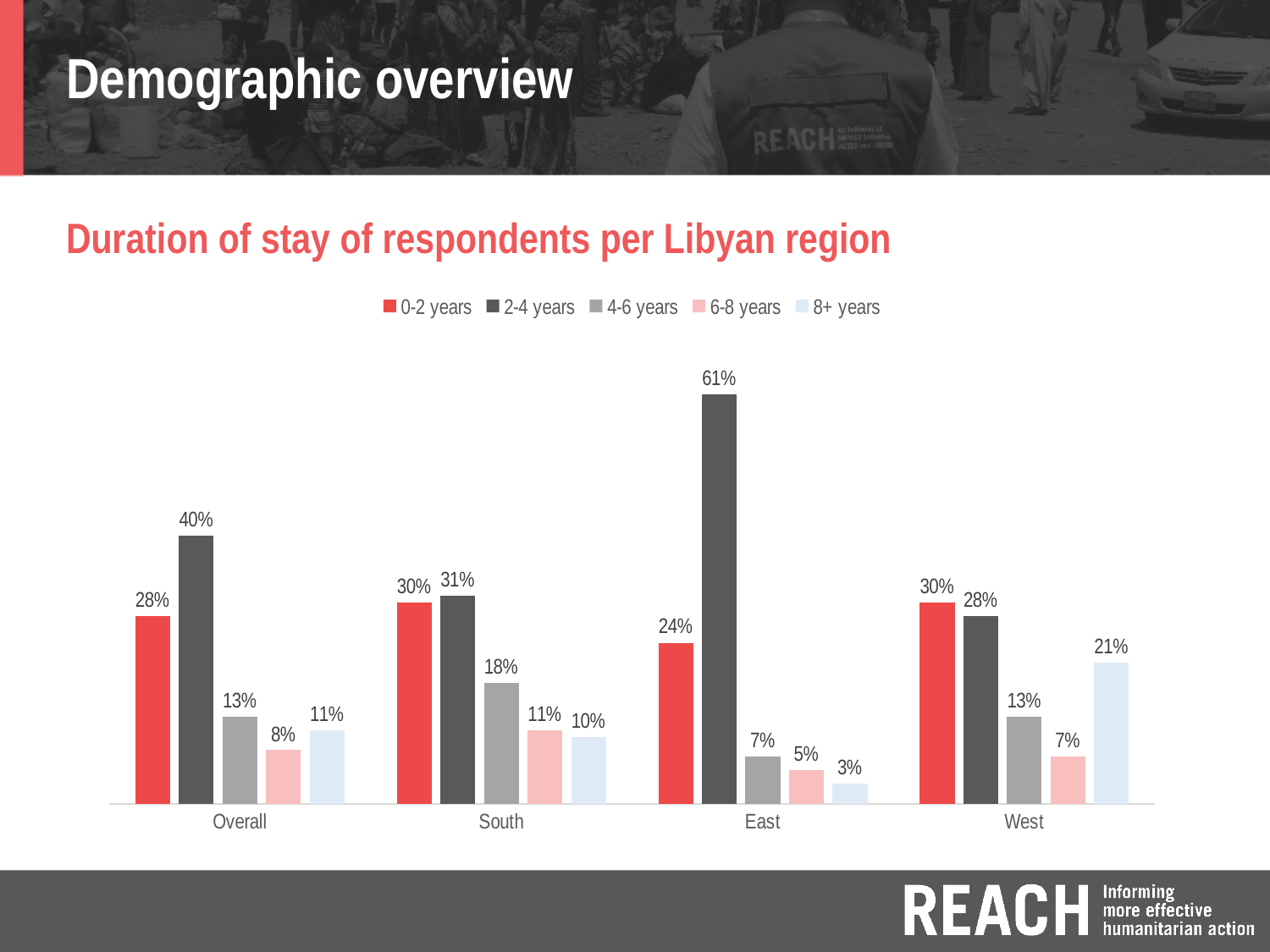
Which is larger in the South region: the 4-6 years value or the 8+ years value? 4-6 years What is the title of the chart? Duration of stay of respondents per Libyan region What is the value for 8+ years in the West region? 21% What is the value for 2-4 years in the East region? 61% Which region has the highest value for 2-4 years? East Which region has the lowest value for 8+ years? East What is the value for 6-8 years in the Overall category? 8% How many regions (categories) are shown on the x axis? 4 Which colour represents the 0-2 years series in the legend? Red How many series does the legend list? 5 What is the difference between the 2-4 years and 0-2 years values in the East region? 37% What kind of chart is shown on the slide? Bar chart